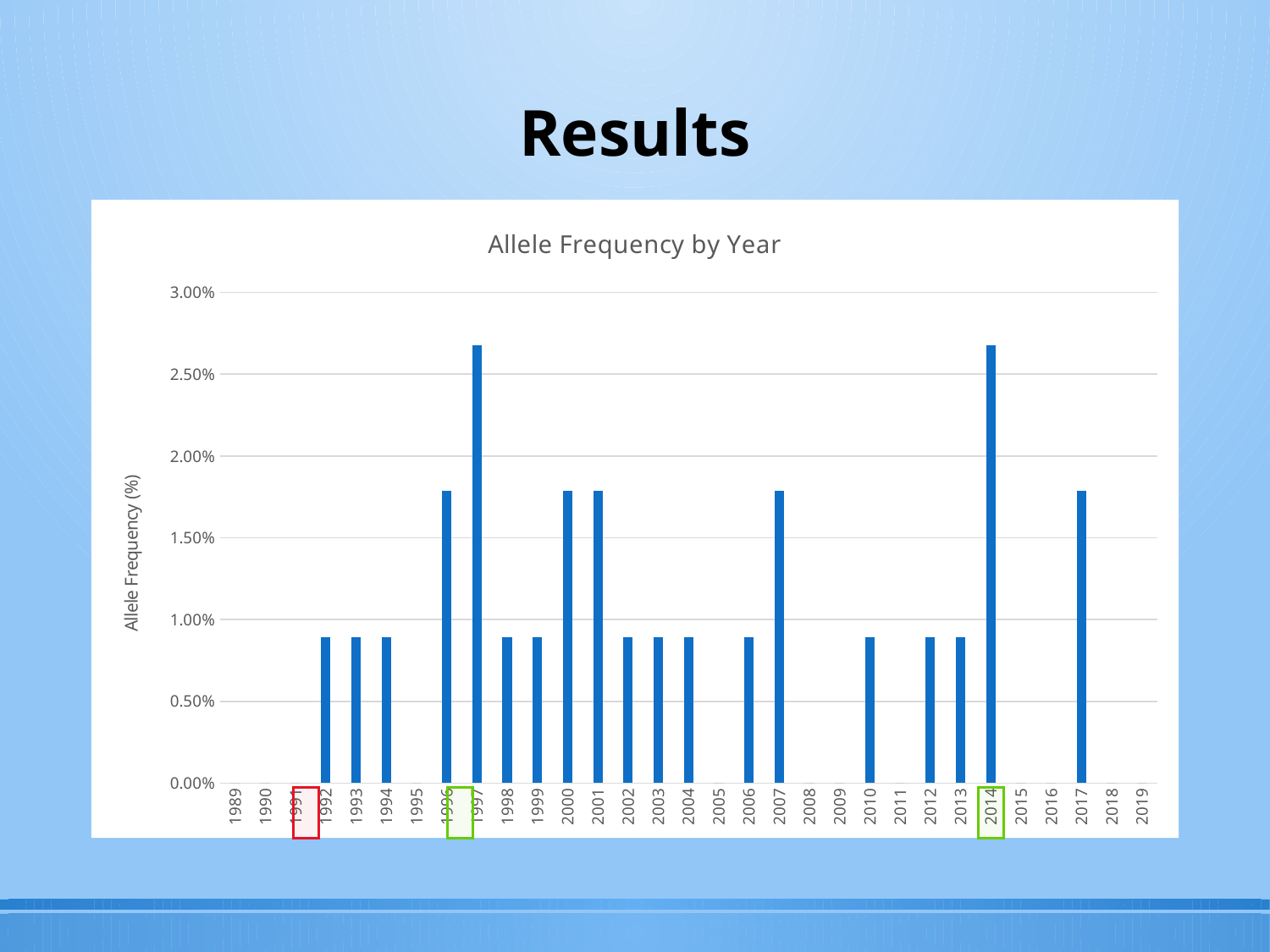
What is the label on the vertical axis of the chart? Allele Frequency (%) Which year has the larger allele frequency, 2007 or 2013? 2007 How many years are listed along the x axis of the chart? 31 Which year has the larger allele frequency, 2014 or 2017? 2014 What kind of chart is shown on the slide? bar chart Is the allele frequency for 2000 greater or less than 1.50%? greater Is the allele frequency for 2017 greater or less than 2.00%? less Is the allele frequency for 1997 greater or less than 2.50%? greater Which year has the larger allele frequency, 1997 or 1992? 1997 What is the title of the chart? Allele Frequency by Year